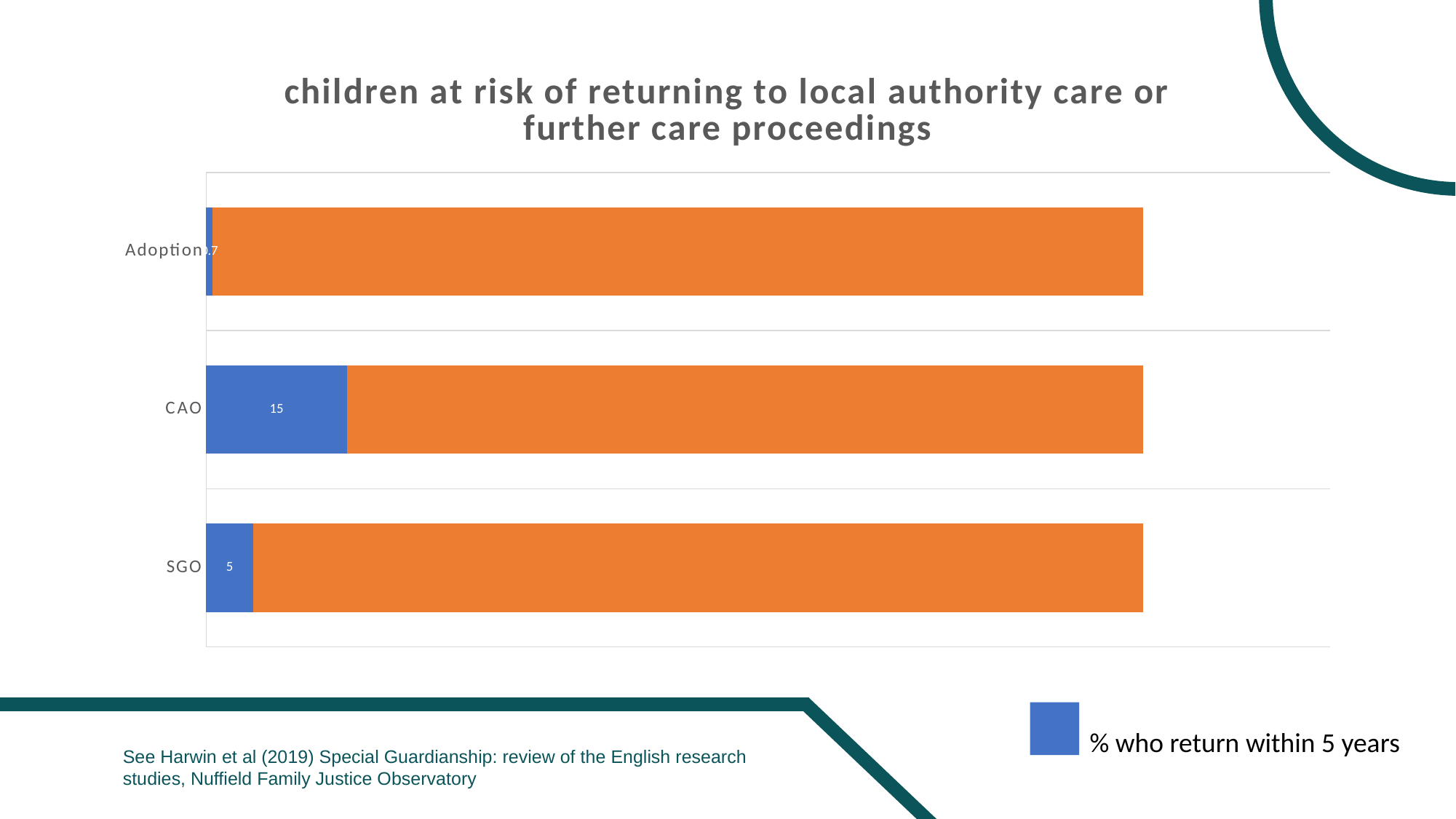
What kind of chart is shown on the slide? Bar chart How many categories are shown on the chart? 3 What is the value of "% who return within 5 years" for SGO? 5 How many series does the legend list? 1 What colour represents the "% who return within 5 years" series? Blue Which category has the highest "% who return within 5 years"? CAO What is the title of the chart? children at risk of returning to local authority care or further care proceedings Which category has the lowest "% who return within 5 years"? Adoption What is the difference between the "% who return within 5 years" values for CAO and SGO? 10 What is the value of "% who return within 5 years" for CAO? 15 Which has a larger "% who return within 5 years", CAO or SGO? CAO